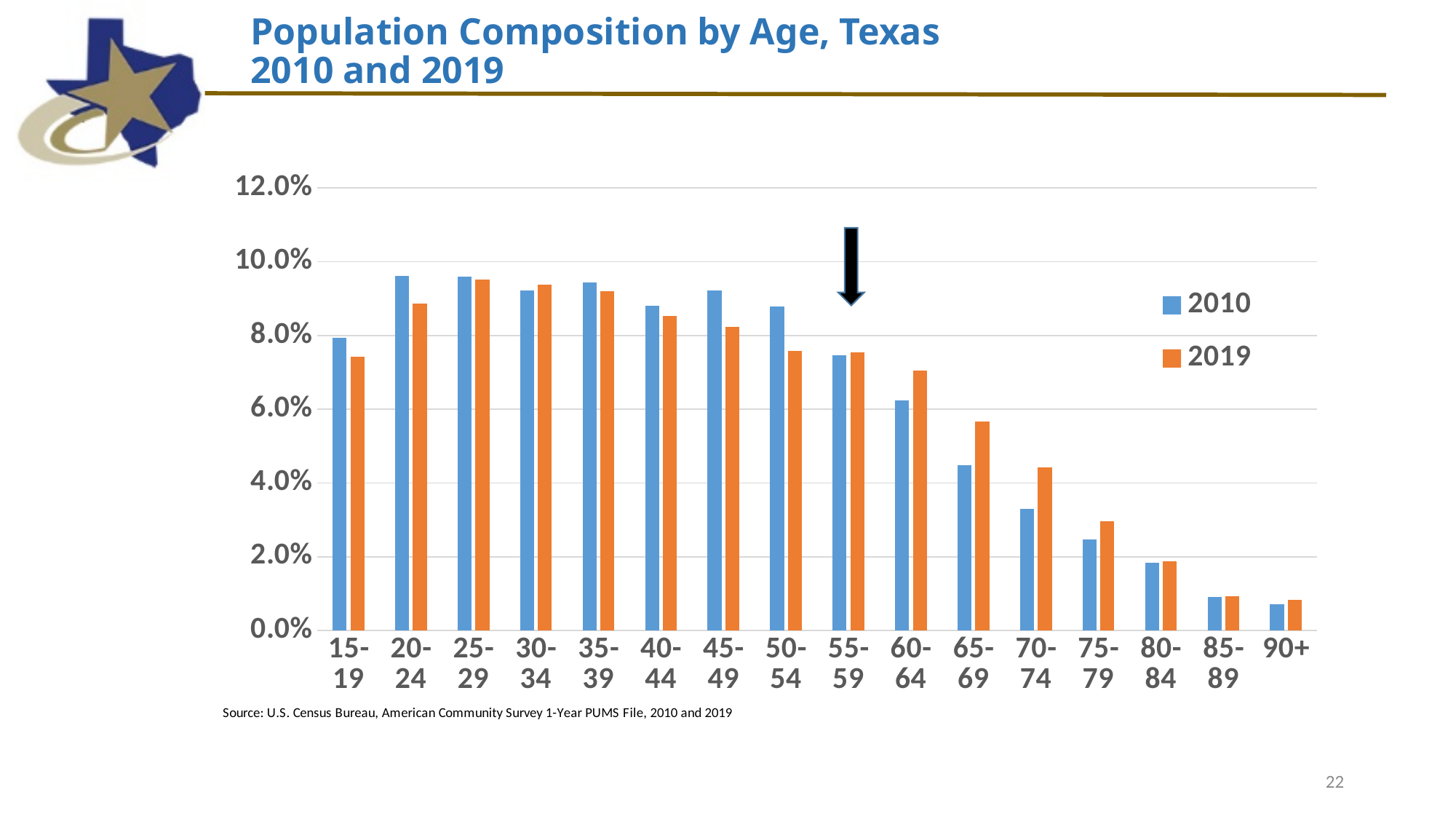
Is the 2019 value for the 65-69 age group greater or less than 6.0%? less Is the 2010 value for the 20-24 age group greater or less than 8.0%? greater For the 15-19 age group, which is larger, the 2010 value or the 2019 value? 2010 Which age group has the lowest value for 2019? 90+ Which age group has the lowest value for 2010? 90+ How many series does the legend list? 2 For the 65-69 age group, which is larger, the 2010 value or the 2019 value? 2019 For the 60-64 age group, which is larger, the 2010 value or the 2019 value? 2019 Do the 2019 values rise or fall across the age groups from 55-59 to 90+? fall Is the 2010 value for the 70-74 age group greater or less than 4.0%? less How many age groups are shown on the x axis? 16 What kind of chart is shown on the slide? bar chart